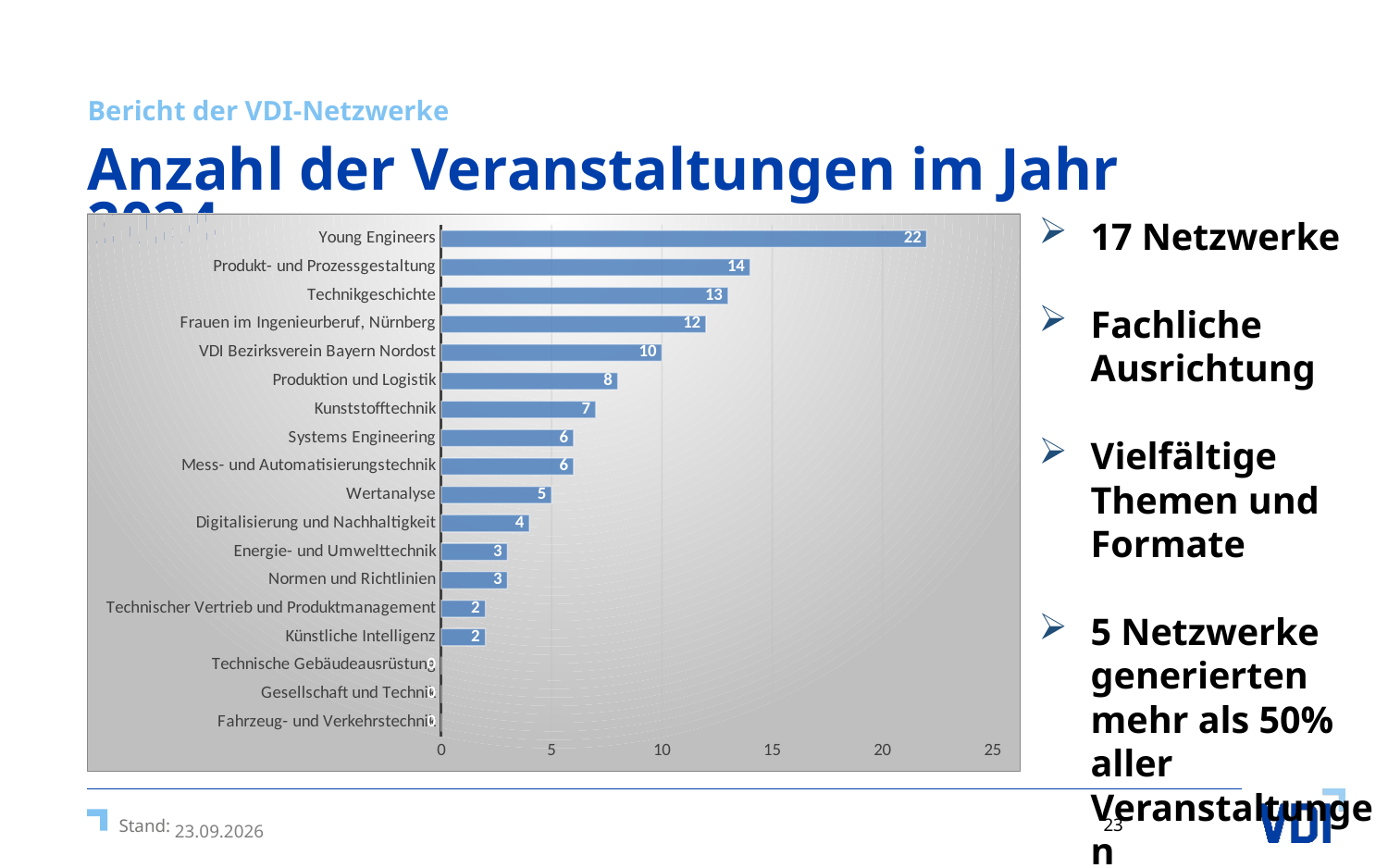
Which has a larger value, Frauen im Ingenieurberuf, Nürnberg or Wertanalyse? Frauen im Ingenieurberuf, Nürnberg How many categories are listed on the vertical axis of the chart? 18 What is the value for VDI Bezirksverein Bayern Nordost? 10 What is the difference between the values for Young Engineers and Produkt- und Prozessgestaltung? 8 What is the difference between the values for Produktion und Logistik and Kunststofftechnik? 1 Is the value for Young Engineers greater or less than 20? greater What kind of chart is shown on the slide? bar chart What is the value for Technikgeschichte? 13 How many events does the chart show for Young Engineers? 22 What is the value for Digitalisierung und Nachhaltigkeit? 4 Which category has the highest value in the chart? Young Engineers What is the highest tick value shown on the horizontal axis? 25